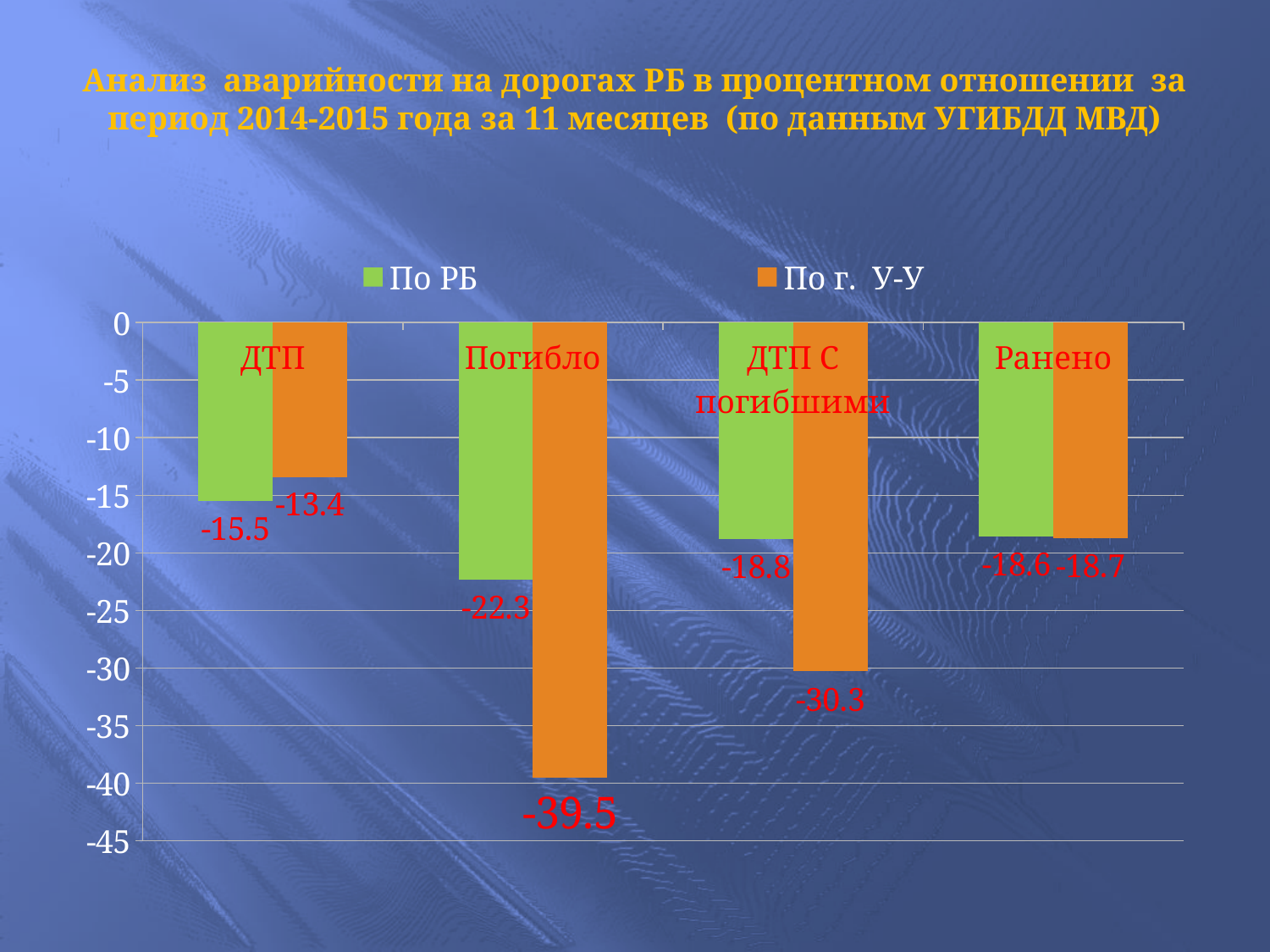
What is the value for Погибло in the По г. У-У series? -39.5 What is the value for ДТП in the По РБ series? -15.5 What is the value for Ранено in the По РБ series? -18.6 What kind of chart is shown on the slide? Bar chart For ДТП, which series has the lower (more negative) value, По РБ or По г. У-У? По РБ Which category has the lowest (most negative) value in the По г. У-У series? Погибло What is the difference between the По г. У-У and По РБ values for ДТП С погибшими? 11.5 How many categories are shown on the x axis? 4 What is the difference between the По г. У-У and По РБ values for Погибло? 17.2 How many series does the legend list? 2 What is the value for ДТП С погибшими in the По г. У-У series? -30.3 Which category has the highest (least negative) value in the По РБ series? ДТП